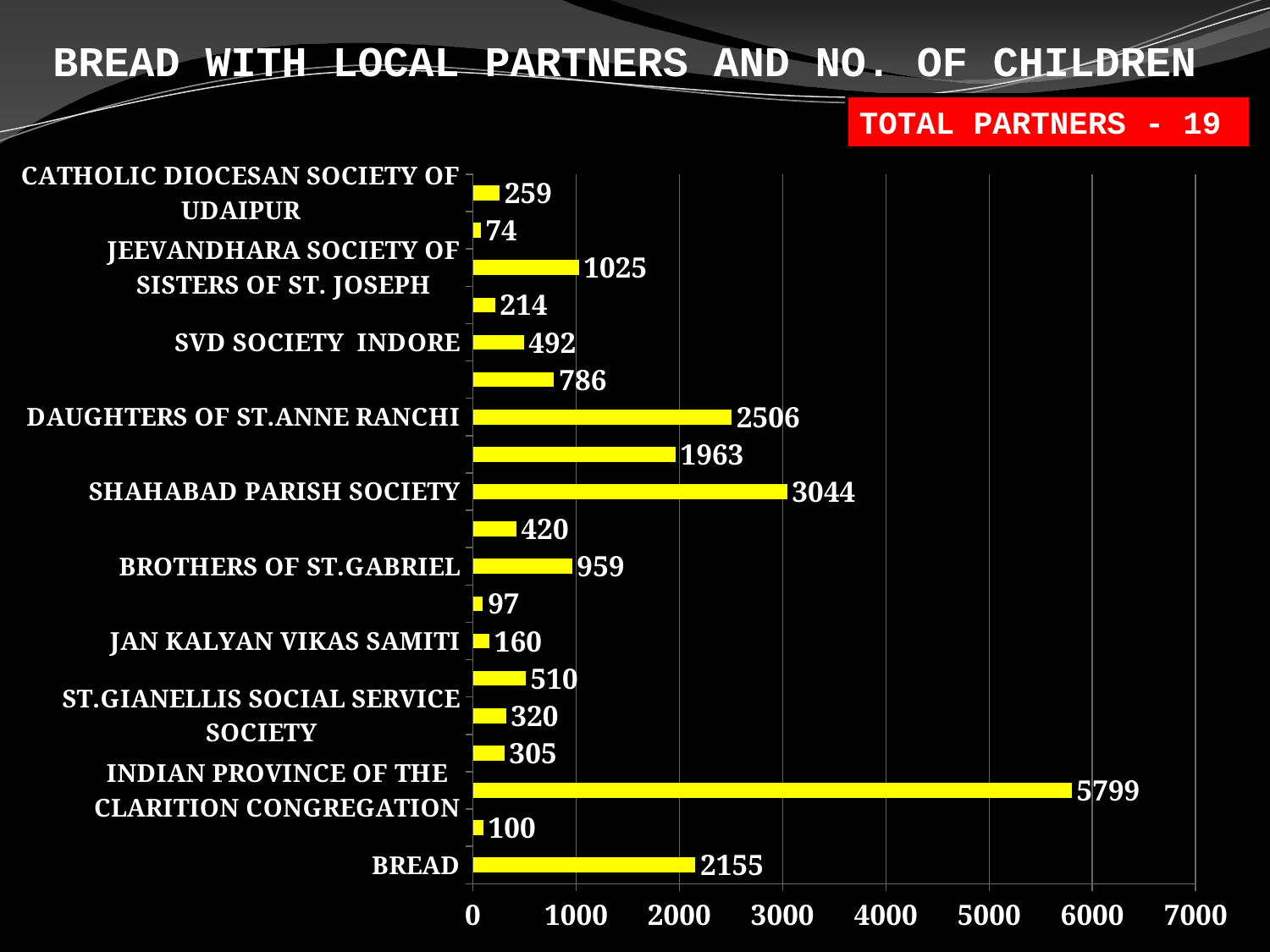
Which has a larger value, BROTHERS OF ST.GABRIEL or SVD SOCIETY INDORE? BROTHERS OF ST.GABRIEL What is the smallest value shown on any bar in the chart? 74 What is the difference between the values for SHAHABAD PARISH SOCIETY and DAUGHTERS OF ST.ANNE RANCHI? 538 What is the number of children for SHAHABAD PARISH SOCIETY? 3044 Is the value for JEEVANDHARA SOCIETY OF SISTERS OF ST. JOSEPH greater or less than 1000? greater What is the number of children for BREAD? 2155 What is the number of children for JAN KALYAN VIKAS SAMITI? 160 What type of chart is shown on the slide? bar chart What total number of partners does the red box on the slide state? 19 Which labelled partner has the highest number of children? INDIAN PROVINCE OF THE CLARITION CONGREGATION What is the number of children for DAUGHTERS OF ST.ANNE RANCHI? 2506 How many bars are plotted in the chart? 19